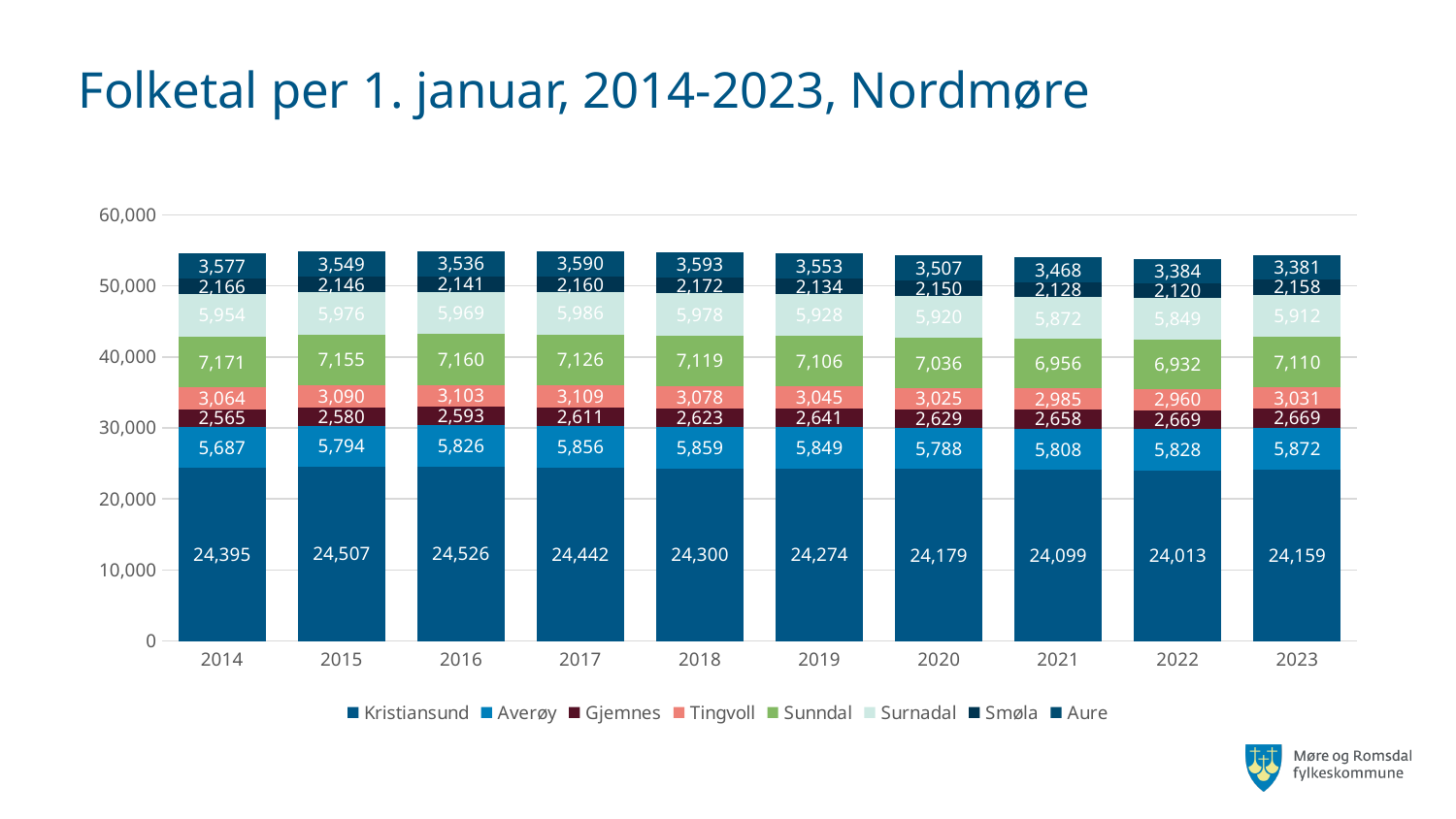
What is the value for Sunndal in 2021? 6,956 Which is larger, the Tingvoll value in 2017 or the Tingvoll value in 2022? 2017 What is the difference between the Kristiansund value in 2014 and in 2023? 236 How many series does the legend list? 8 In which year is the Kristiansund value highest? 2016 What is the value for Kristiansund in 2016? 24,526 How many years are shown on the x axis? 10 In which year is the Kristiansund value lowest? 2022 What is the total of the stacked bar for 2014? 54,579 What is the value for Aure in 2018? 3,593 What is the title of the chart? Folketal per 1. januar, 2014-2023, Nordmøre What type of chart is shown on the slide? Stacked bar chart